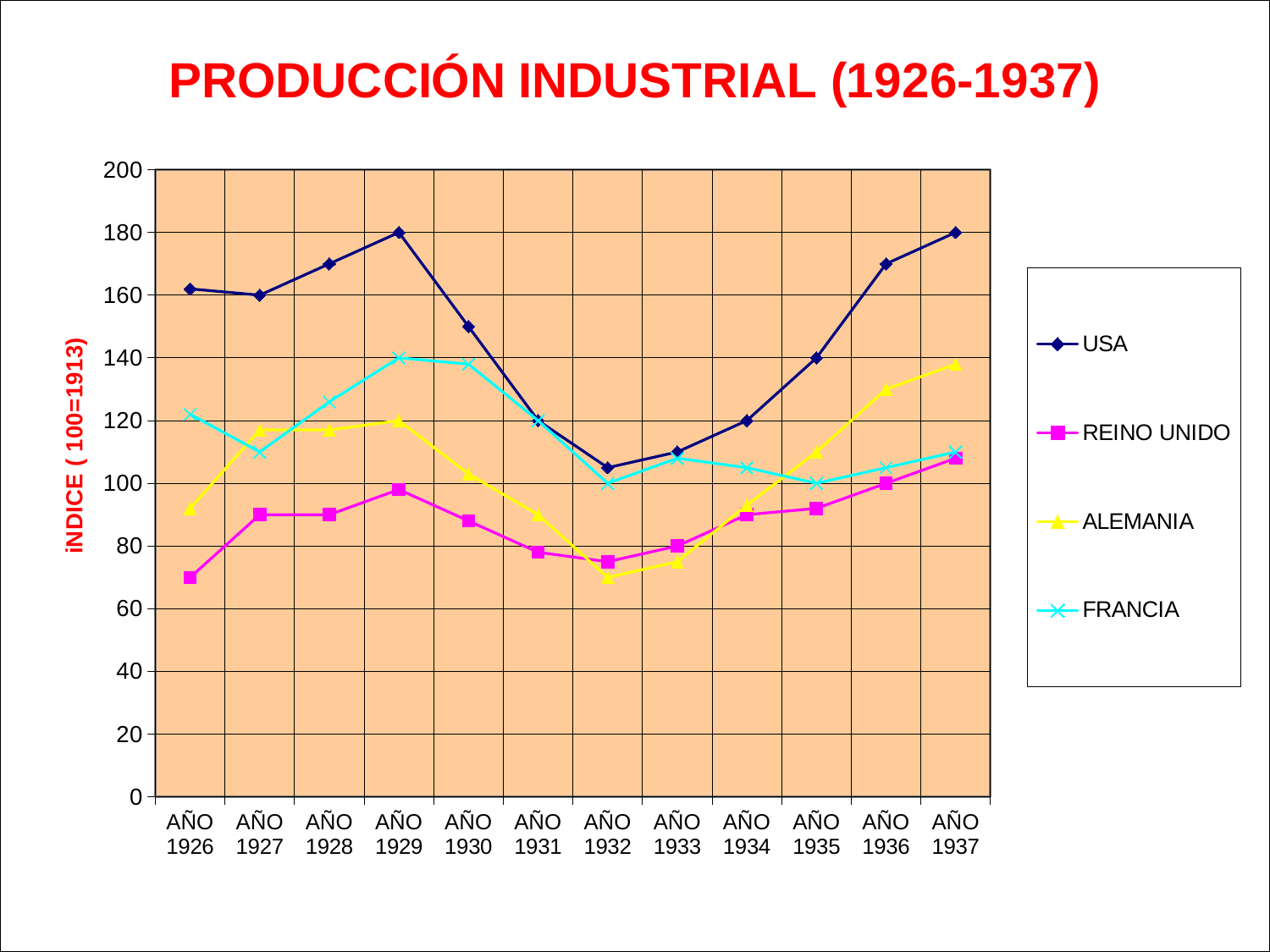
Is the value for ALEMANIA in AÑO 1932 greater or less than 80? less Does the USA series rise or fall from AÑO 1929 to AÑO 1932? fall Which series has the lowest value in AÑO 1929? REINO UNIDO How many series does the legend list? 4 What kind of chart is shown on the slide? line chart Which is larger in AÑO 1936, the value for ALEMANIA or the value for FRANCIA? ALEMANIA Which series has the highest value in AÑO 1926? USA What is the value for USA in AÑO 1929? 180 What is the value for FRANCIA in AÑO 1929? 140 What is the value for USA in AÑO 1937? 180 How many years are plotted along the x axis? 12 What is the value for REINO UNIDO in AÑO 1936? 100